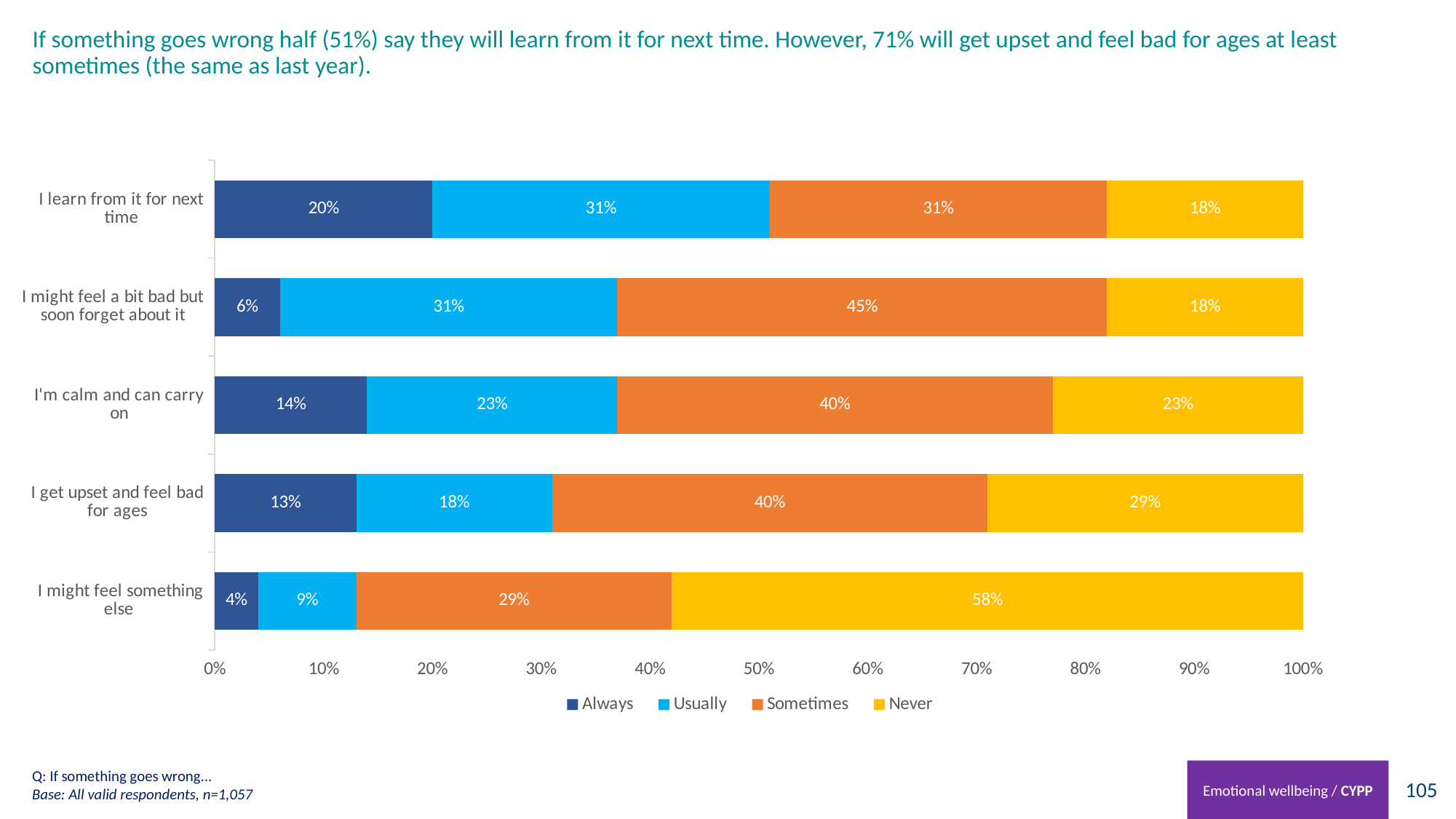
Which category has the highest 'Never' value? I might feel something else What is the combined 'Always' and 'Usually' value for 'I learn from it for next time'? 51% How many categories are shown on the chart? 5 Which category has the lowest 'Always' value? I might feel something else What is the 'Never' value for 'I might feel something else'? 58% Which colour represents the 'Sometimes' series in the legend? Orange How many series does the legend list? 4 What is the 'Sometimes' value for 'I might feel a bit bad but soon forget about it'? 45% Which is larger: the 'Usually' value for 'I'm calm and can carry on' or the 'Usually' value for 'I get upset and feel bad for ages'? I'm calm and can carry on What percentage of respondents say they 'Always' learn from it for next time? 20% What kind of chart is shown on the slide? Stacked bar chart What is the difference between the 'Never' values for 'I get upset and feel bad for ages' and 'I learn from it for next time'? 11%